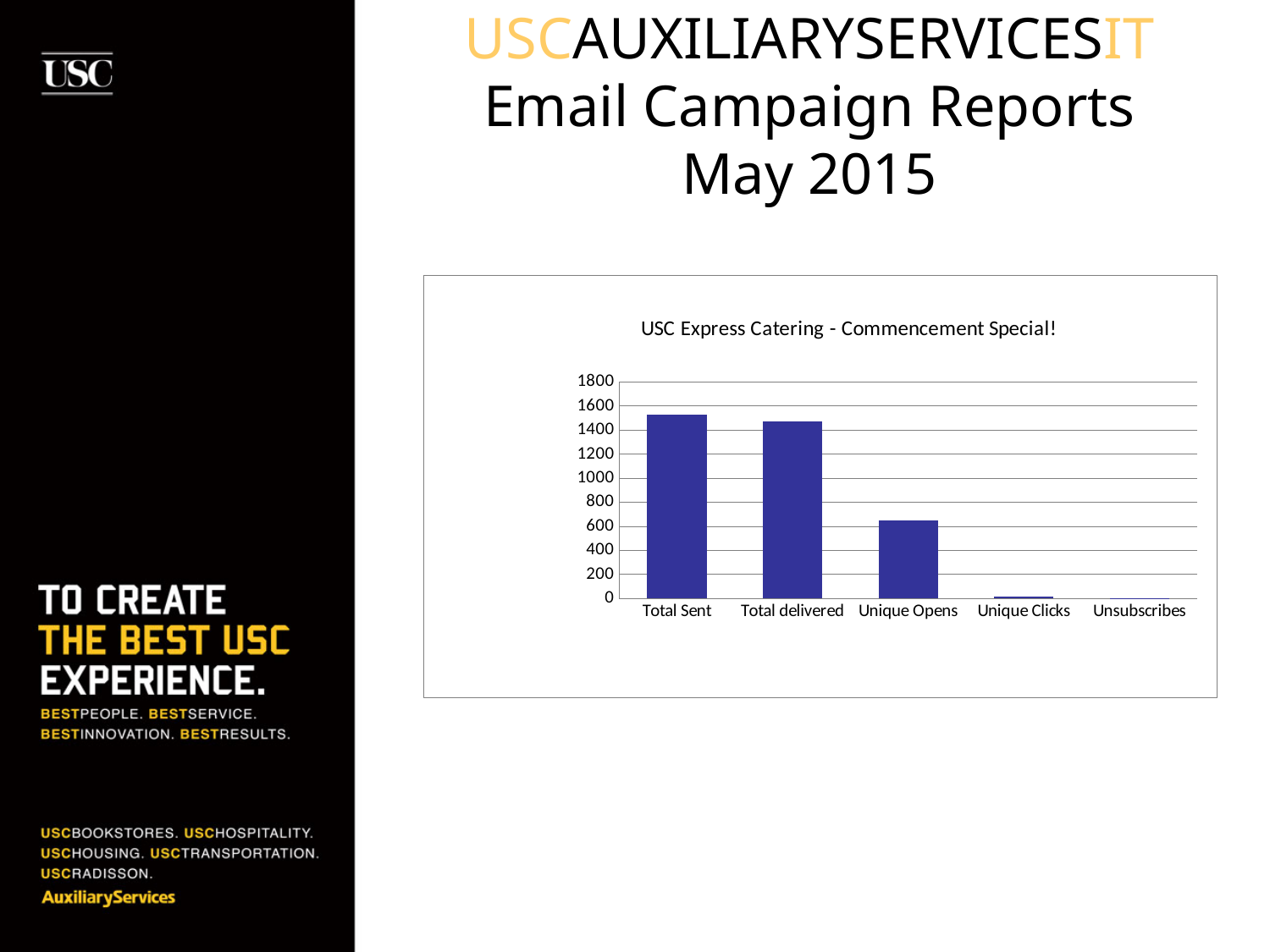
Is the value for Total Sent greater or less than 1600? less Which category has the highest value in the chart? Total Sent Do the values rise or fall moving from left to right along the x axis? fall Is the value for Unique Clicks greater or less than 200? less What is the title of the chart? USC Express Catering - Commencement Special! Is the value for Total delivered greater or less than 1400? greater What kind of chart is shown on the slide? bar chart Which is larger, Total Sent or Total delivered? Total Sent How many categories are shown on the x axis of the chart? 5 Which is larger, Unique Opens or Unique Clicks? Unique Opens